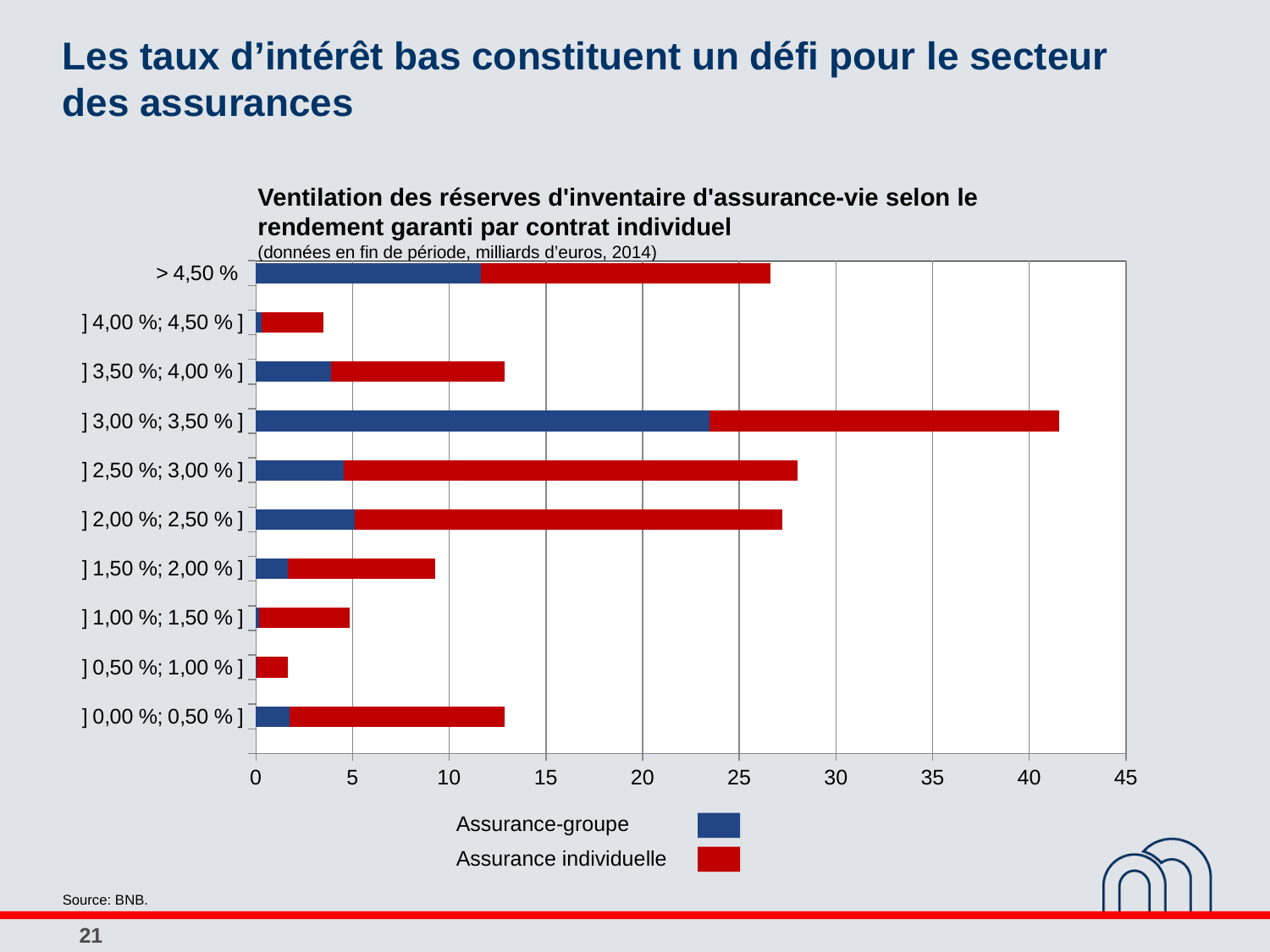
Which guaranteed-return category has the smallest total reserves in the chart? ] 0,50 %; 1,00 % ] Is the total bar for the category ] 0,00 %; 0,50 % ] greater or less than 10? greater What unit and year are given in the chart's subtitle? milliards d'euros, 2014 Which series is shown in red in the chart's legend? Assurance individuelle Is the total bar for the category > 4,50 % greater or less than 25? greater Is the total bar for the category ] 1,50 %; 2,00 % ] greater or less than 10? less What kind of chart is shown on the slide? Stacked horizontal bar chart Which has the larger total bar: the category > 4,50 % or the category ] 3,50 %; 4,00 % ]? > 4,50 % How many guaranteed-return categories are shown on the vertical axis of the chart? 10 Which guaranteed-return category has the largest total reserves in the chart? ] 3,00 %; 3,50 % ] How many series does the chart's legend list? 2